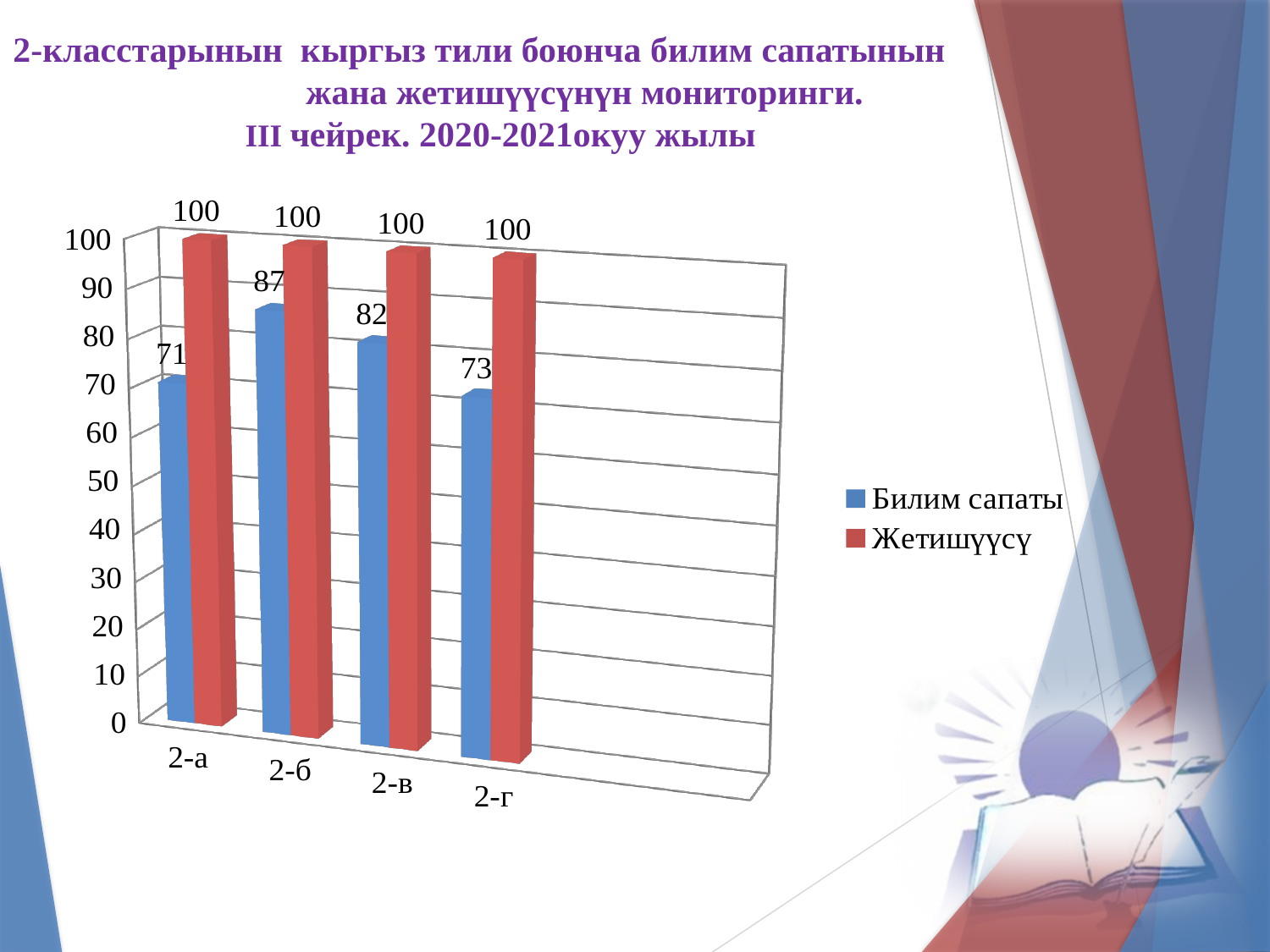
What is the value of Жетишүүсү for 2-в? 100 What is the difference between the Билим сапаты values for 2-б and 2-а? 16 Which is larger: the Билим сапаты value for 2-в or for 2-г? 2-в Which colour represents the Жетишүүсү series? red Which category has the lowest Билим сапаты value? 2-а What kind of chart is shown on the slide? bar chart What is the value of Билим сапаты for 2-г? 73 What is the value of Билим сапаты for 2-а? 71 What is the value of Билим сапаты for 2-б? 87 How many series does the legend list? 2 How many categories are shown on the x axis? 4 Which category has the highest Билим сапаты value? 2-б